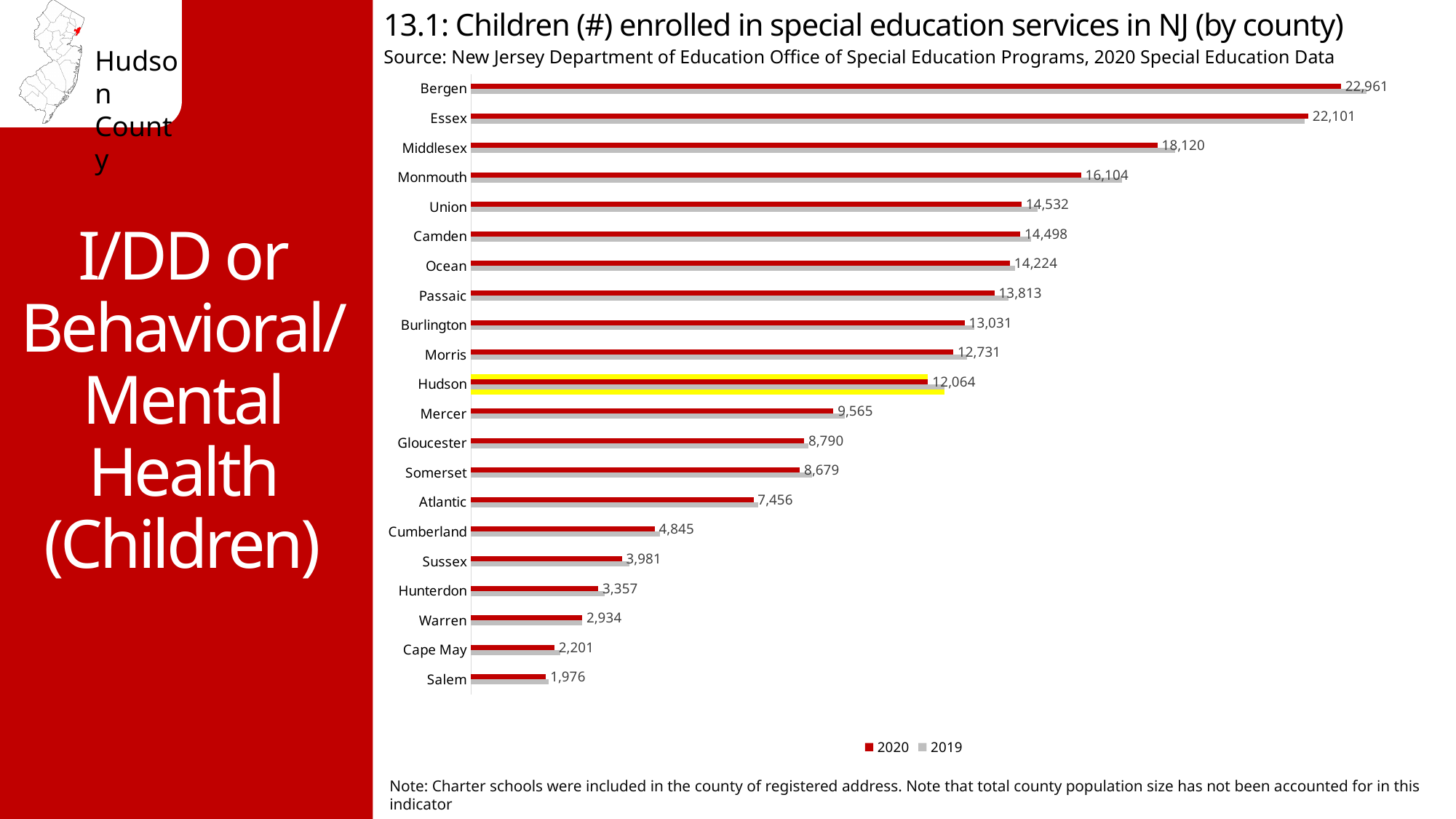
What is the 2020 value for Hudson county? 12,064 Which county has the lowest number of children enrolled in special education services in 2020? Salem Which years are listed in the chart legend? 2020 and 2019 Which county has a larger 2020 value, Middlesex or Monmouth? Middlesex Which county has the highest number of children enrolled in special education services in 2020? Bergen What is the difference between the 2020 values for Bergen and Essex? 860 How many counties are shown in the chart? 21 What is the difference between the 2020 values for Hudson and Mercer? 2,499 What is the 2020 value for Bergen county? 22,961 What is the 2020 value for Cumberland county? 4,845 How many series does the legend list? 2 What kind of chart is shown on the slide? Bar chart